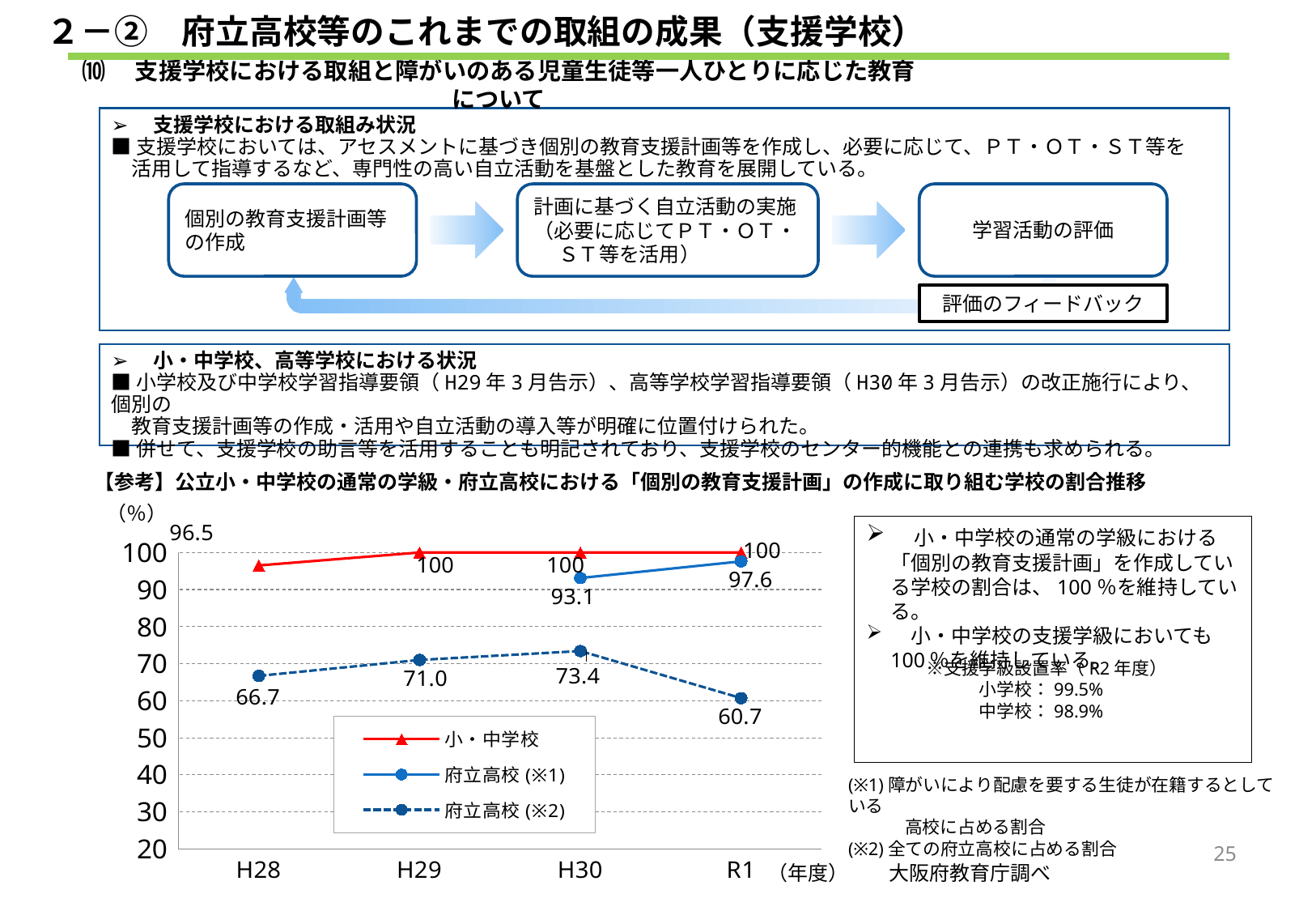
How many series does the chart legend list? 3 Does the 府立高校 (※2) series rise or fall from H30 to R1? fall In which fiscal year is the 府立高校 (※2) series at its highest? H30 What is the difference between the 府立高校 (※1) value and the 府立高校 (※2) value in R1? 36.9 What is the value for 府立高校 (※1) in R1? 97.6 What is the value for 小・中学校 in H28? 96.5 In which fiscal year is the 府立高校 (※2) series at its lowest? R1 What is the value for 府立高校 (※2) in H30? 73.4 How many fiscal years are plotted on the x axis of the chart? 4 What is the value for 府立高校 (※2) in R1? 60.7 Which is larger in H30: the value for 府立高校 (※1) or the value for 府立高校 (※2)? 府立高校 (※1) What kind of chart is shown on the slide? line chart